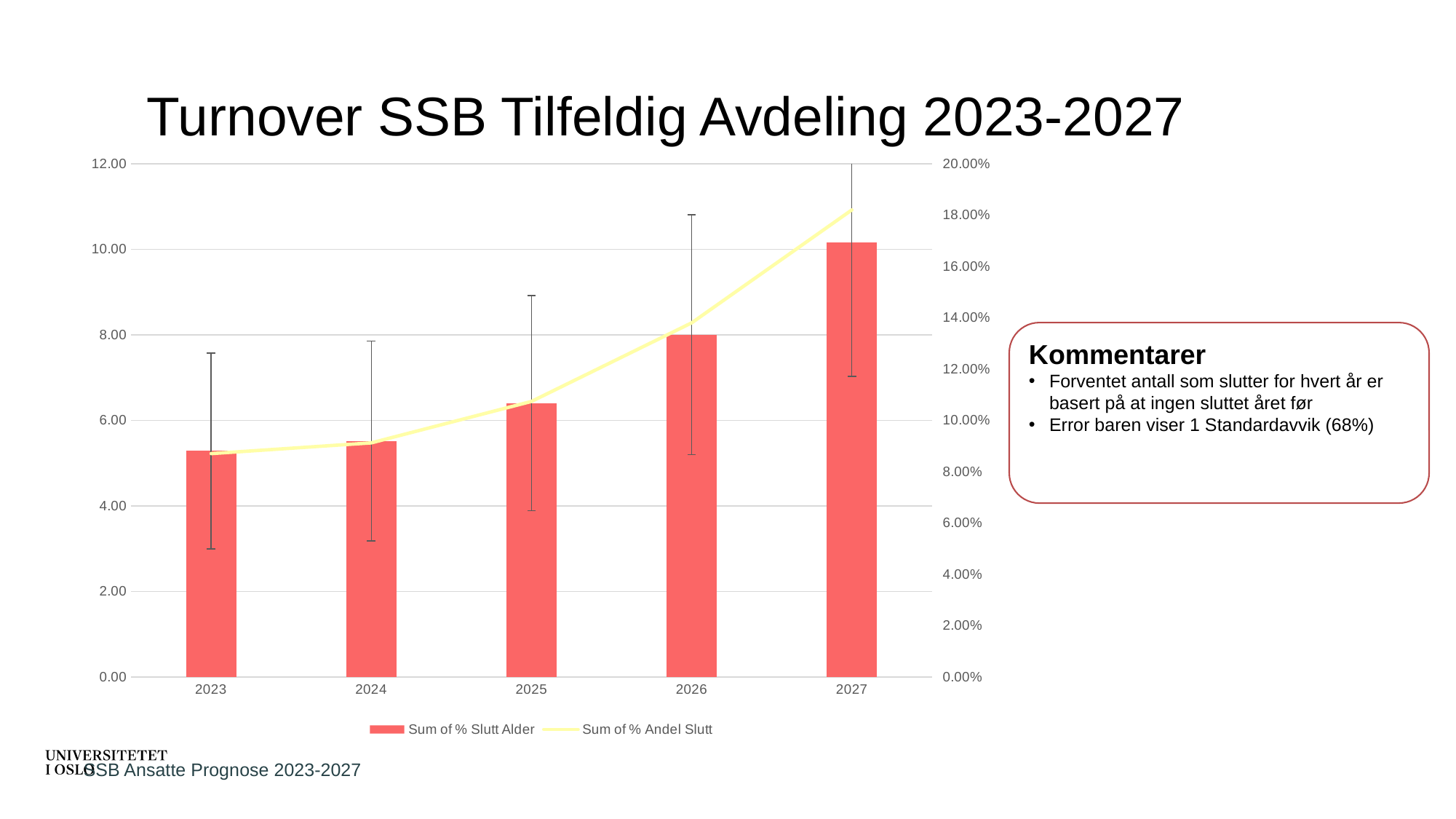
Is the bar for Sum of % Slutt Alder in 2023 greater or less than 6.00? less What is the title of the chart? Turnover SSB Tilfeldig Avdeling 2023-2027 Is the bar for Sum of % Slutt Alder in 2025 greater or less than 6.00? greater Which bar is taller for Sum of % Slutt Alder, 2026 or 2027? 2027 Which series is drawn as a line in the chart? Sum of % Andel Slutt Do the Sum of % Slutt Alder bars rise or fall from 2023 to 2027? rise Is the Sum of % Andel Slutt line value for 2023 greater or less than 10.00%? less Which year has the highest bar for Sum of % Slutt Alder? 2027 How many years are shown on the x axis of the chart? 5 How many series does the chart legend list? 2